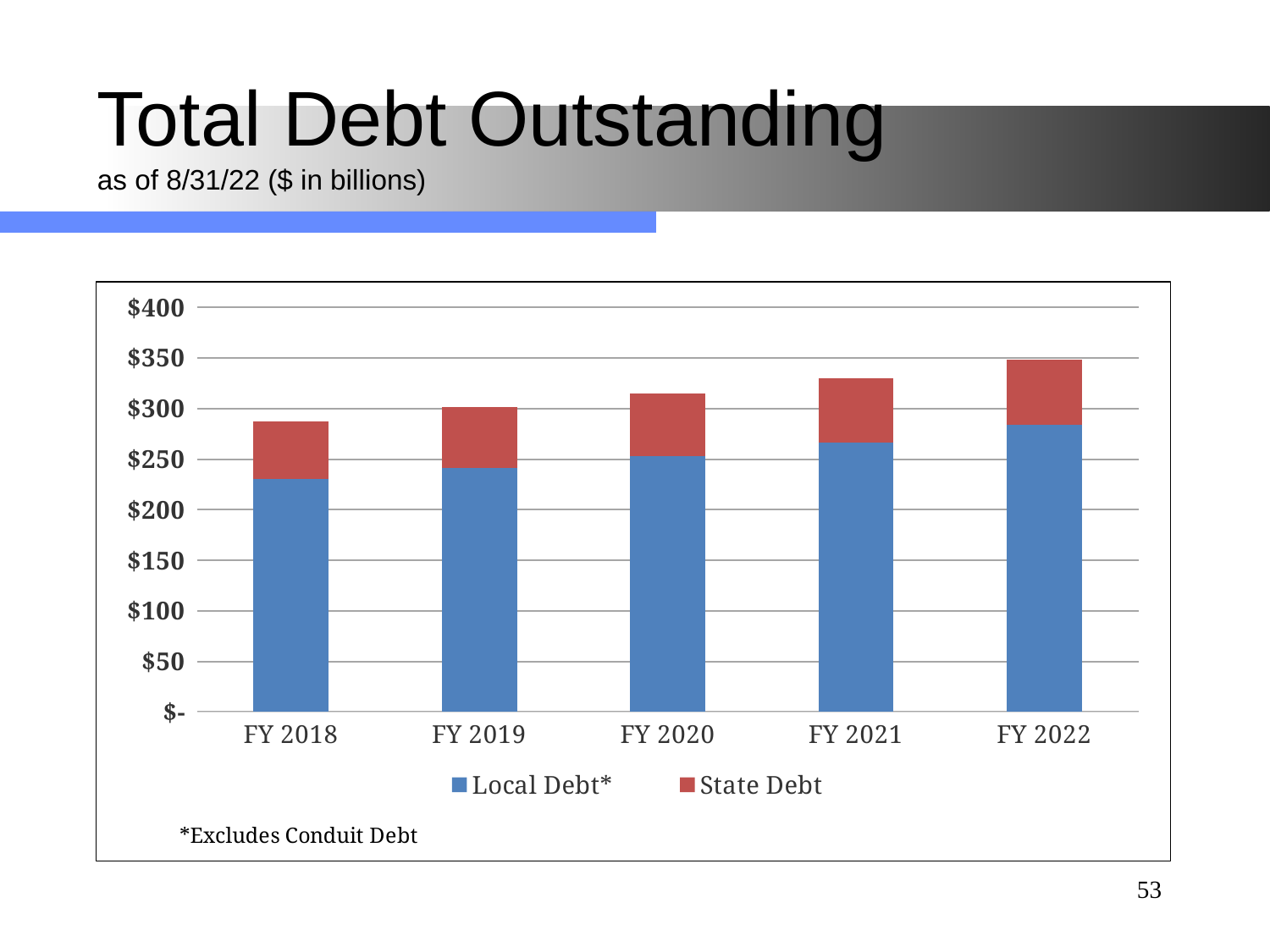
Which series is shown in blue in the legend? Local Debt* Which fiscal year has the shortest total bar? FY 2018 Is the Local Debt* value for FY 2018 greater or less than $200? greater Is the total bar for FY 2021 greater or less than $350? less How many series does the legend list? 2 What kind of chart is shown on the slide? Stacked bar chart Is the total bar for FY 2022 greater or less than $300? greater What does the footnote below the legend say? *Excludes Conduit Debt How many fiscal years are shown on the x axis? 5 Which fiscal year has the tallest total bar? FY 2022 Do the total debt bars rise or fall from FY 2018 to FY 2022? Rise